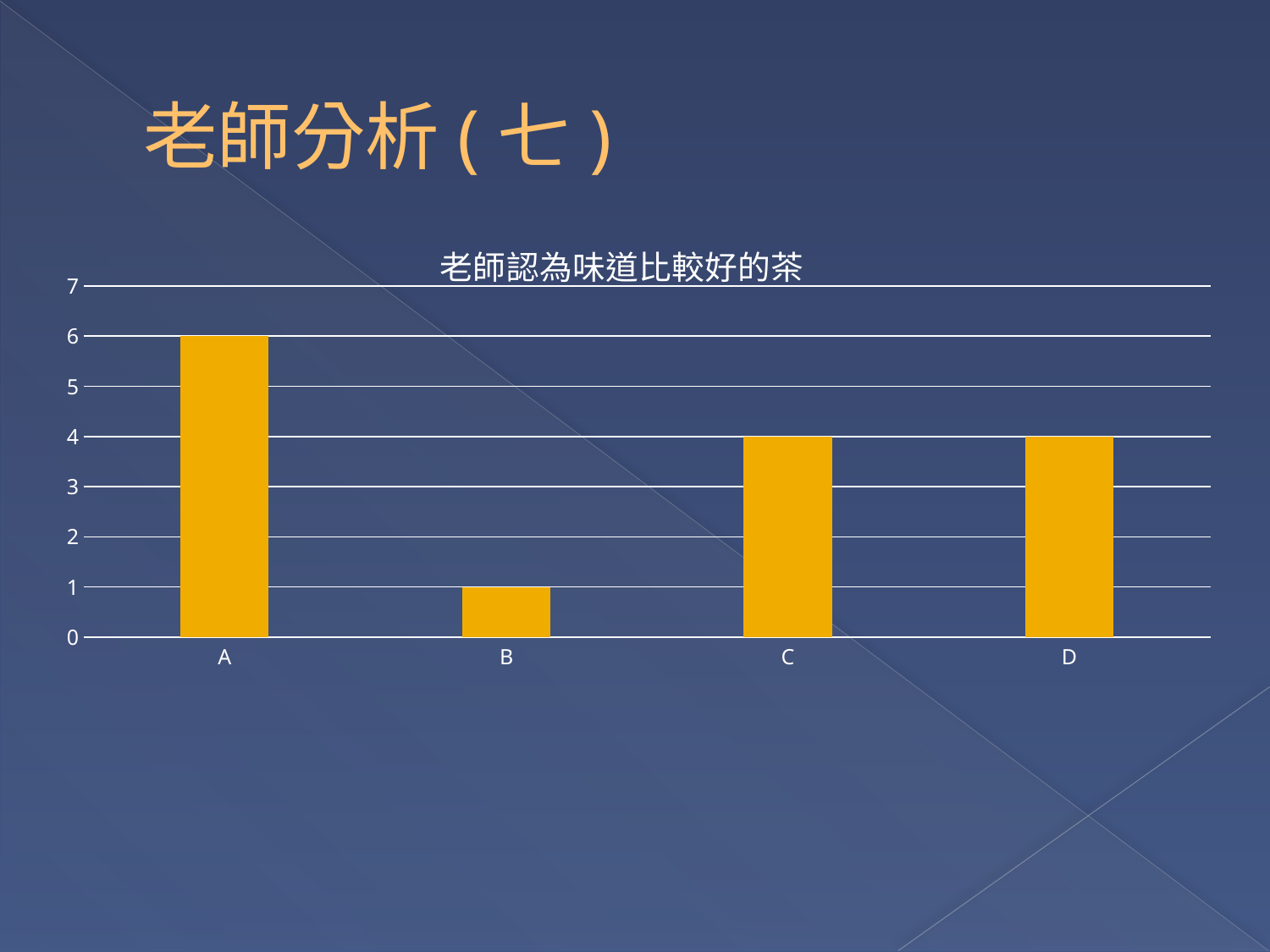
What is the value for C? 4 Which category has the lowest value? B What type of chart is shown on the slide? bar chart What is the value for B? 1 Which category has the highest value? A Which is larger, the value for A or the value for C? A What is the value for A? 6 What is the difference between the values for A and B? 5 How many categories are shown on the x axis of the chart? 4 What is the title of the chart? 老師認為味道比較好的茶 What is the value for D? 4 Is the value for A greater or less than 5? greater